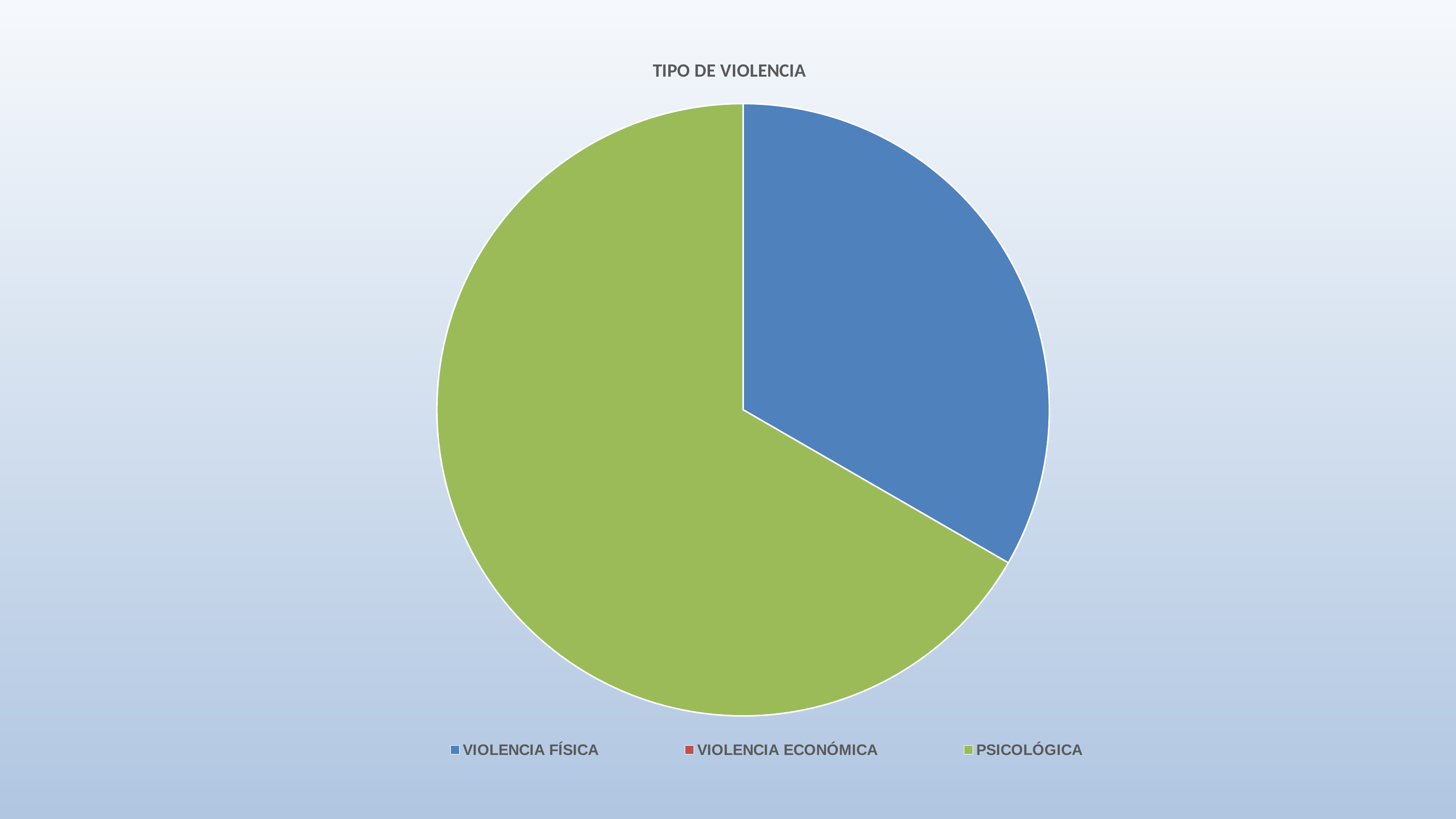
What kind of chart is shown on the slide? pie chart Which category has the largest slice of the pie? PSICOLÓGICA Which is larger, the slice for VIOLENCIA FÍSICA or the slice for PSICOLÓGICA? PSICOLÓGICA Is the share of the pie for PSICOLÓGICA greater or less than half? greater What is the title of the chart? TIPO DE VIOLENCIA How many categories does the legend of the pie chart list? 3 Which category has the smallest share of the pie? VIOLENCIA ECONÓMICA Which colour represents VIOLENCIA FÍSICA in the pie chart? blue Is the share of the pie for VIOLENCIA FÍSICA greater or less than half? less